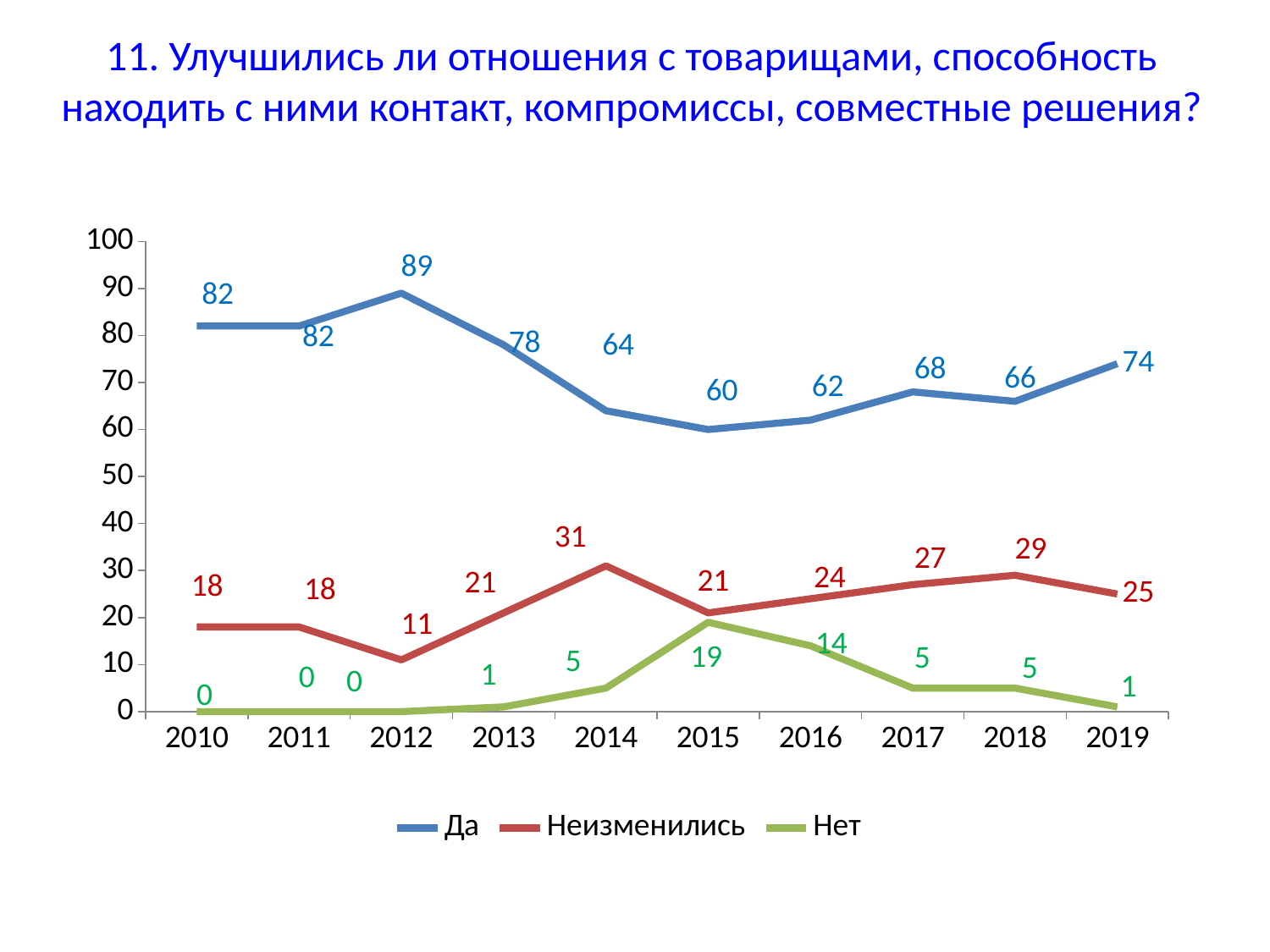
How many series does the legend list? 3 What is the value for "Неизменились" in 2014? 31 How many years are shown on the x axis? 10 Which is larger: the "Неизменились" value in 2018 or in 2019? 2018 What is the value for "Да" in 2012? 89 Does the "Да" series rise or fall from 2012 to 2015? fall What are the three series listed in the legend? Да, Неизменились, Нет What kind of chart is shown on the slide? line chart What is the value for "Нет" in 2015? 19 In which year is the "Да" series at its lowest? 2015 What is the difference between the "Да" values in 2012 and 2019? 15 In which year is the "Нет" series at its highest? 2015